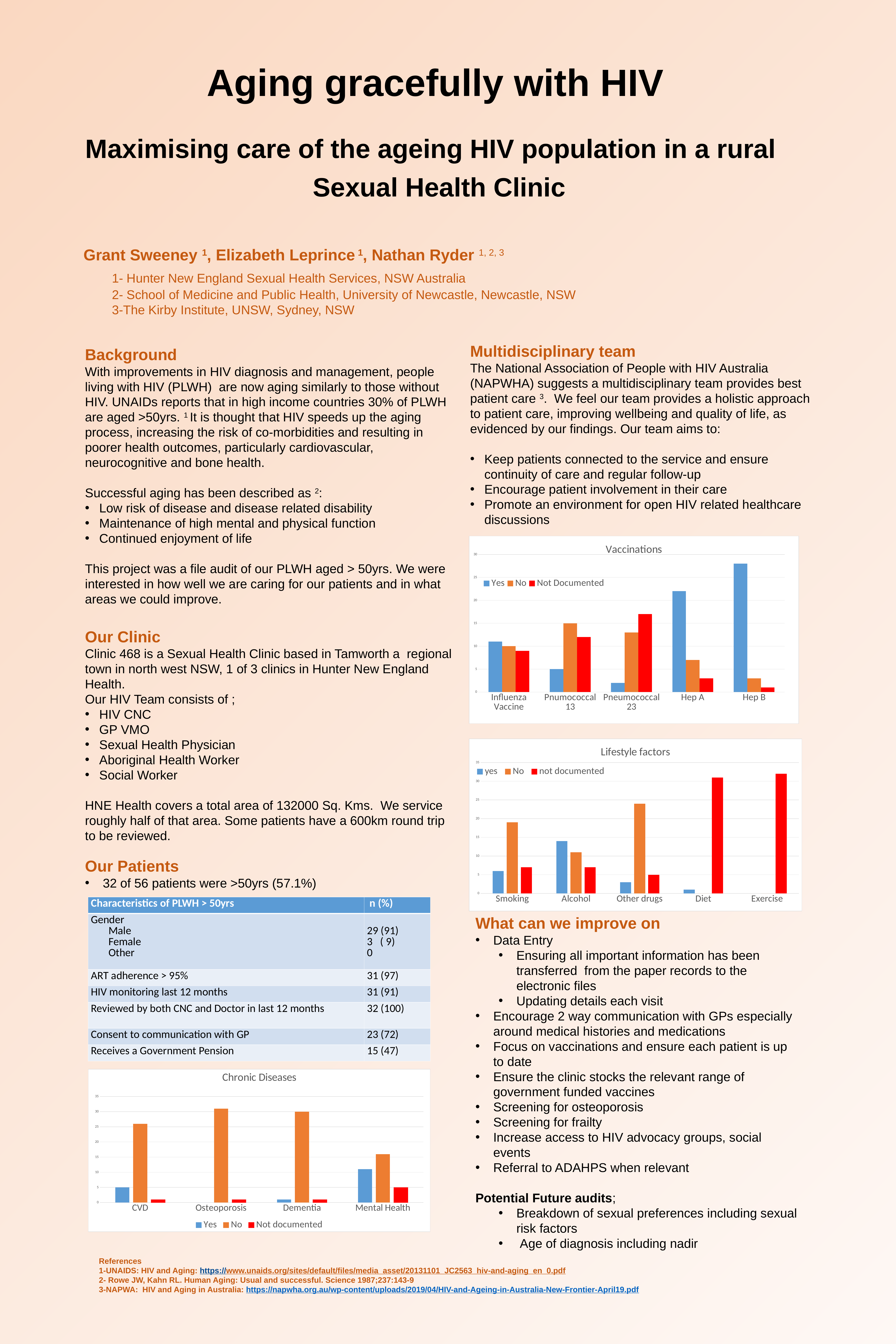
How many series does the legend of the Vaccinations chart list? 3 In the Lifestyle factors chart, which category has the highest No value? Other drugs How many categories are shown on the x axis of the Lifestyle factors chart? 5 In the Vaccinations chart, which vaccine has the highest Yes value? Hep B In the Vaccinations chart, is the Yes value for Pneumococcal 23 greater or less than 5? less In the Chronic Diseases chart, which disease has the highest Yes value? Mental Health In the Chronic Diseases chart, is the No value for Osteoporosis greater or less than 25? greater What kind of chart is the Vaccinations chart? bar chart In the Lifestyle factors chart, is the not documented value for Diet greater or less than 25? greater In the Lifestyle factors chart, which has the larger yes value, Smoking or Alcohol? Alcohol What are the legend entries of the Chronic Diseases chart? Yes, No, Not documented